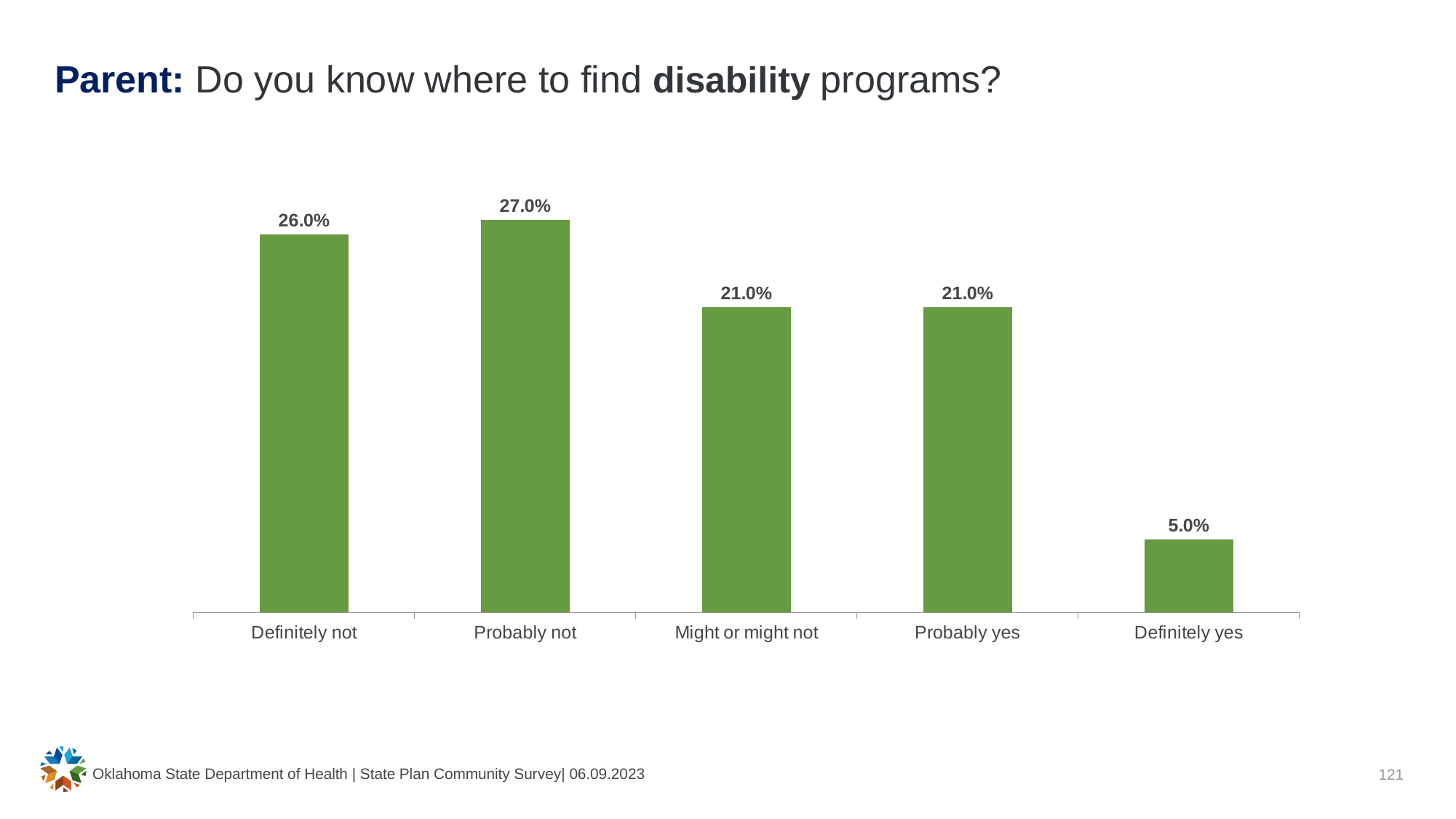
What is the value for "Probably not"? 27.0% What percentage is shown for "Definitely yes"? 5.0% What is the difference between "Probably not" and "Definitely yes"? 22.0% What is the difference between "Definitely not" and "Probably yes"? 5.0% Which response category has the highest value? Probably not What is the value for "Might or might not"? 21.0% What kind of chart is shown on the slide? Bar chart Which response category has the lowest value? Definitely yes What percentage of parents answered "Definitely not"? 26.0% Which is larger, the value for "Definitely not" or the value for "Definitely yes"? Definitely not How many response categories are shown on the chart? 5 What colour are the bars in the chart? Green